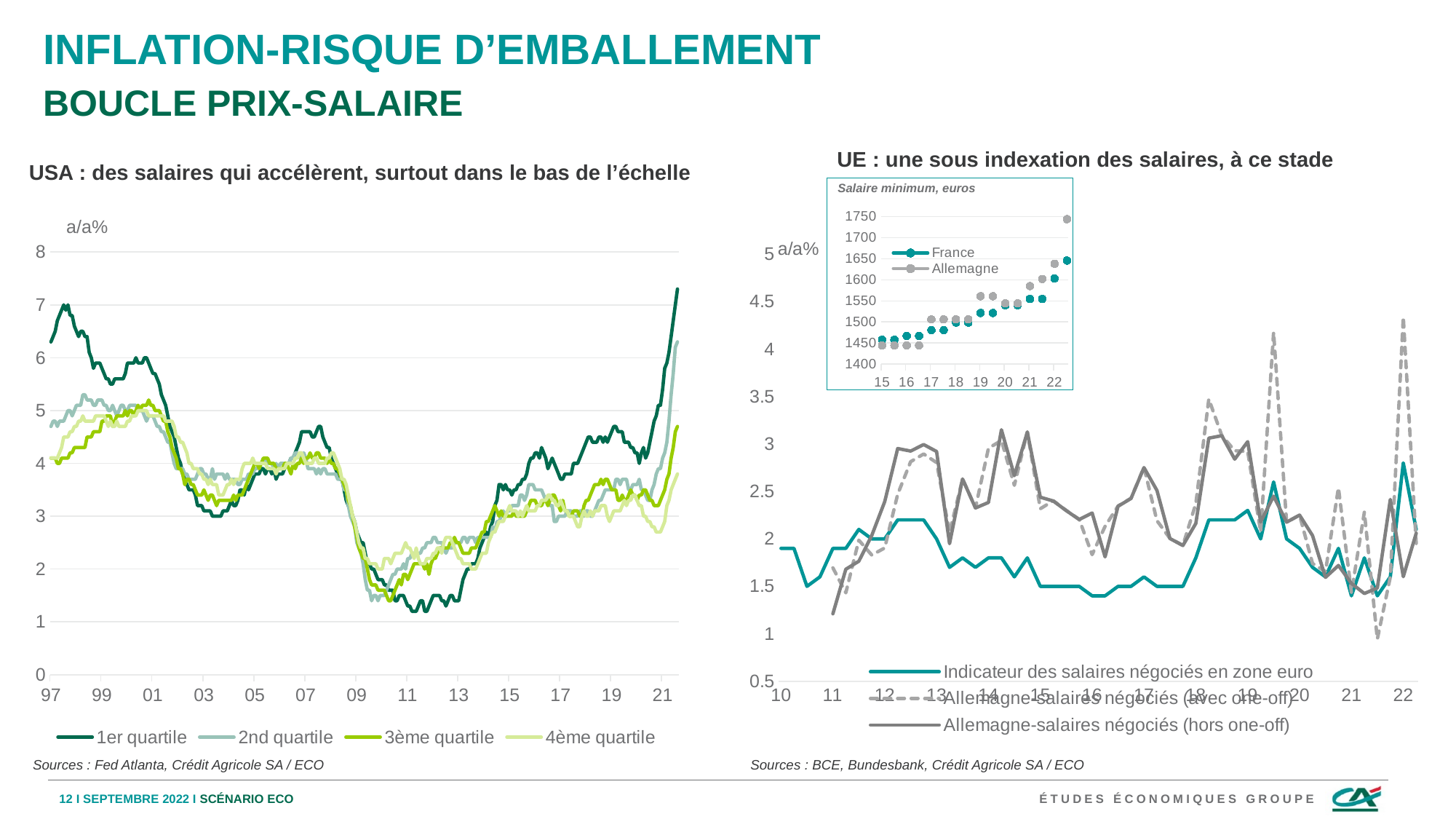
In the left USA chart, which series reaches the highest value at the right end of the x axis (2021-2022)? 1er quartile What kind of chart is the left chart titled 'USA : des salaires qui accélèrent, surtout dans le bas de l'échelle'? line chart In the left USA chart, do the values of the 1er quartile series rise or fall between 2008 and 2010? fall In the right UE chart, is the 2019 peak of the 'Allemagne-salaires négociés (avec one-off)' series greater or less than 4? greater How many series does the legend of the right chart titled 'UE : une sous indexation des salaires, à ce stade' list? 3 How many series does the legend of the left USA chart list? 4 In the right UE chart, which series reaches the highest peak? Allemagne-salaires négociés (avec one-off) What is the y-axis label of the left USA chart? a/a% In the right UE chart, is the 2022 peak of the 'Indicateur des salaires négociés en zone euro' series greater or less than 3? less In the inset chart 'Salaire minimum, euros', do the France values rise or fall from 2015 to 2022? rise In the left USA chart, is the final value of the 1er quartile series greater or less than 6? greater